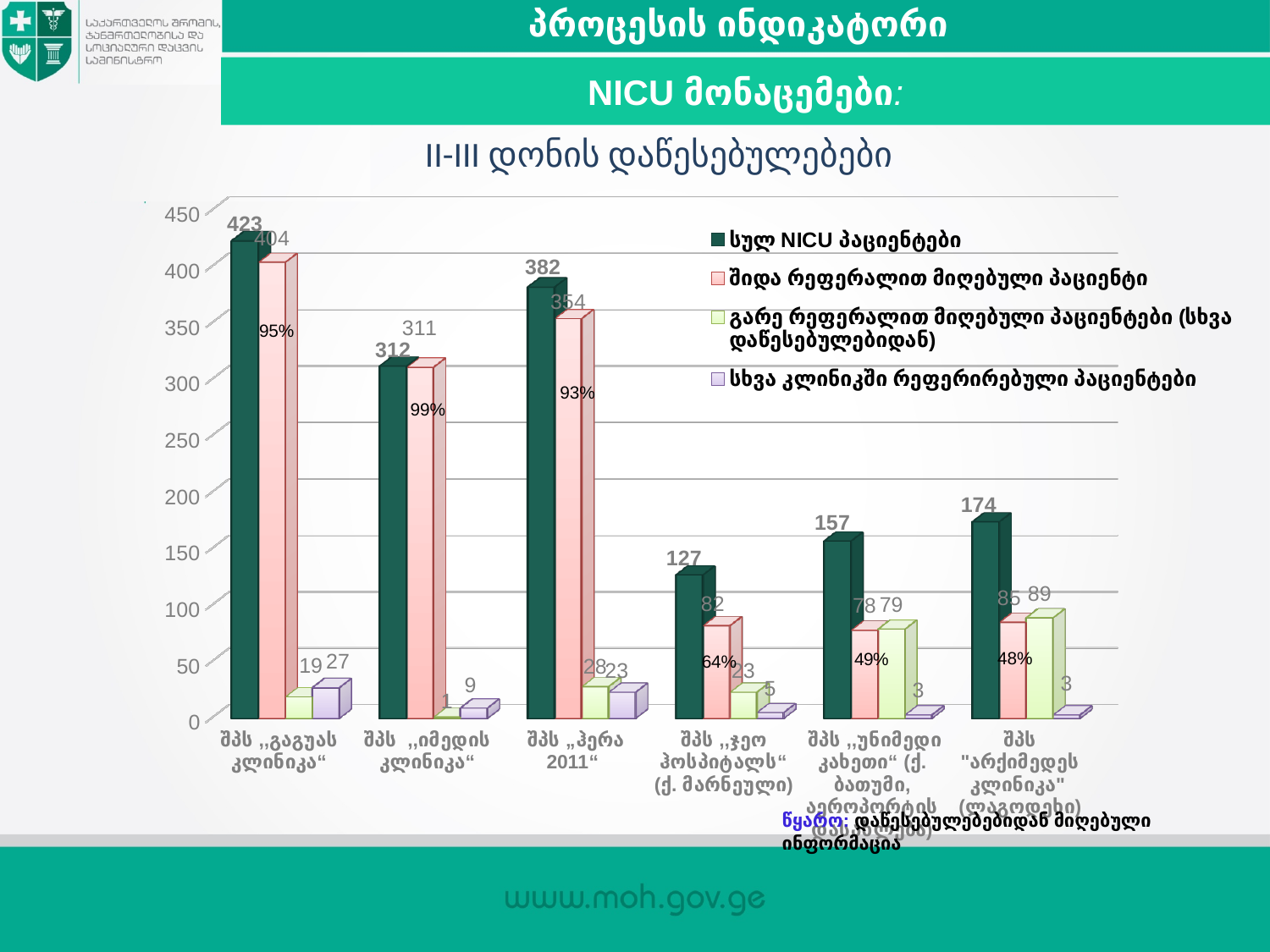
What is the value of გარე რეფერალით მიღებული პაციენტები for შპს „უნიმედი კახეთი“? 79 How many institutions (categories) are shown on the x axis of the chart? 6 How many series does the chart legend list? 4 What is the difference between სულ NICU პაციენტები and შიდა რეფერალით მიღებული პაციენტი for შპს „იმედის კლინიკა“? 1 Which institution has the highest value of სულ NICU პაციენტები? შპს „გაგუას კლინიკა“ What is the title of the chart? II-III დონის დაწესებულებები What type of chart is shown on the slide? bar chart What percentage label is shown on the შიდა რეფერალით bar for შპს „ჯეო ჰოსპიტალს“ (ქ. მარნეული)? 64% Which institution has the lowest value of სულ NICU პაციენტები? შპს „ჯეო ჰოსპიტალს“ (ქ. მარნეული) What is the value of სულ NICU პაციენტები for შპს „გაგუას კლინიკა“? 423